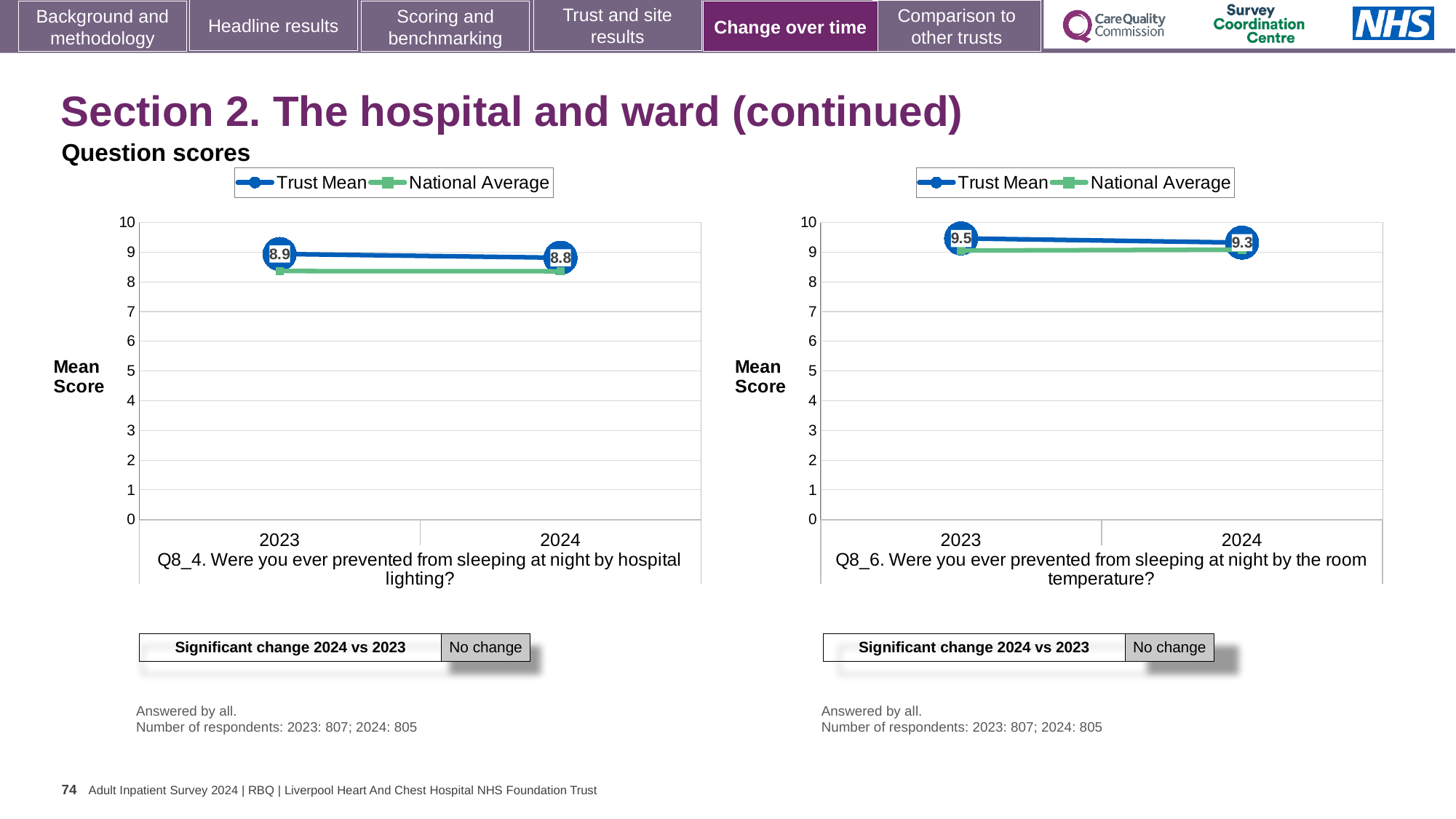
In the Q8_4 hospital lighting chart, what is the Trust Mean score for 2023? 8.9 In the Q8_6 room temperature chart, is the National Average for 2023 greater or less than 8? greater In the Q8_4 hospital lighting chart, what is the Trust Mean score for 2024? 8.8 In the Q8_6 room temperature chart, by how much did the Trust Mean change from 2023 to 2024? 0.2 How many series does the legend of the Q8_6 room temperature chart list? 2 In the Q8_6 room temperature chart, what is the Trust Mean score for 2023? 9.5 How many years are shown on the x axis of the Q8_6 room temperature chart? 2 In the Q8_4 hospital lighting chart, which is higher in 2023, the Trust Mean or the National Average? Trust Mean In the Q8_6 room temperature chart, what is the Trust Mean score for 2024? 9.3 In the Q8_4 hospital lighting chart, is the National Average for 2024 greater or less than 9? less What kind of chart is the Q8_4 hospital lighting chart? line chart In the Q8_4 hospital lighting chart, does the Trust Mean rise or fall from 2023 to 2024? fall